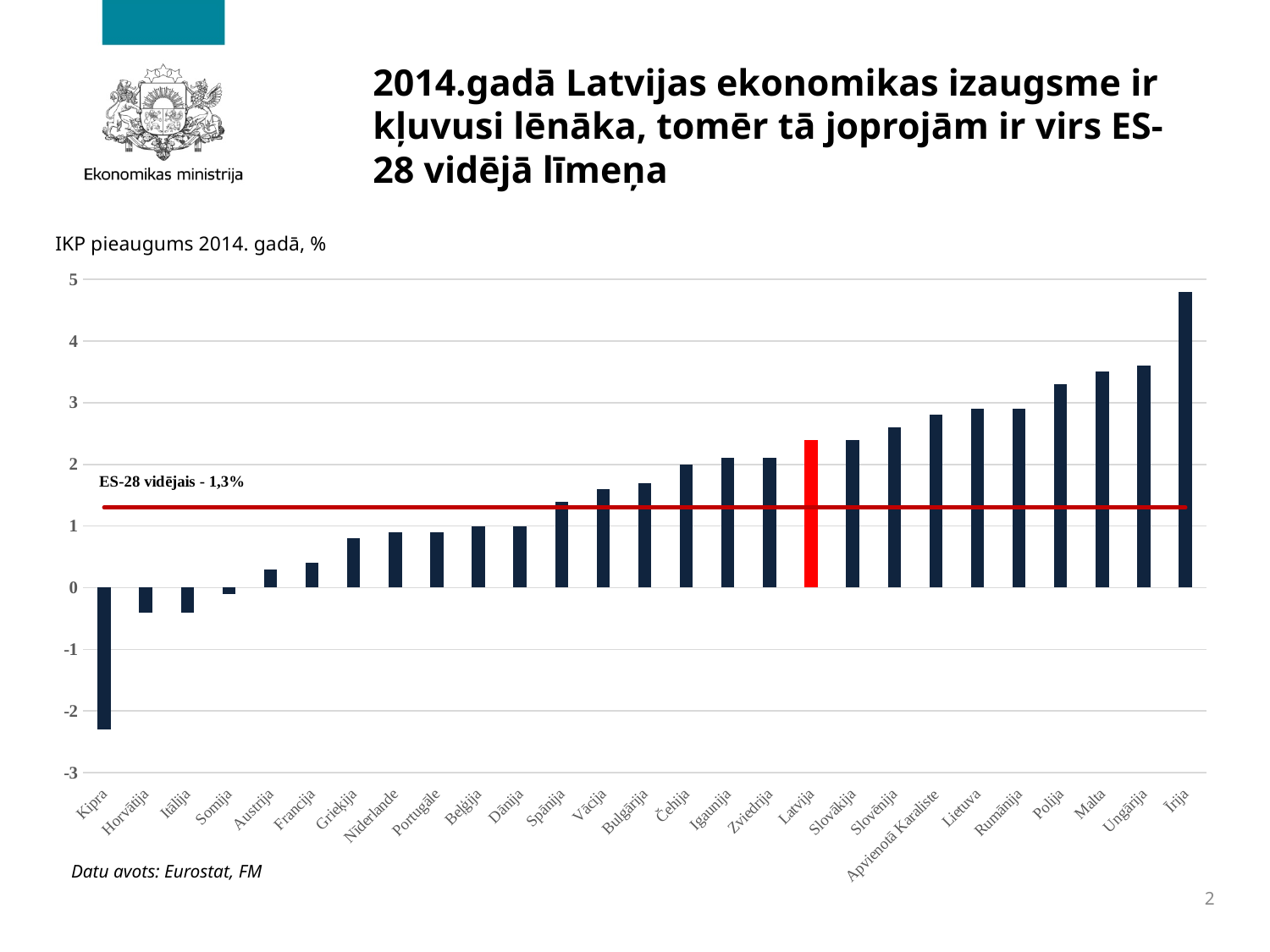
Is the value for Īrija greater or less than 4? greater Do the values generally rise or fall moving from left to right along the x axis? rise Which country has the lowest GDP growth in the chart? Kipra Which country has the highest GDP growth in the chart? Īrija How many countries are shown on the x axis of the chart? 27 Is the value for Kipra greater or less than -2? less Is the value for Latvija greater or less than 2? greater What is the ES-28 average value marked by the horizontal line on the chart? 1,3% Which country's bar is highlighted in red on the chart? Latvija What kind of chart is shown on the slide? bar chart Which has the larger value, Malta or Īrija? Īrija